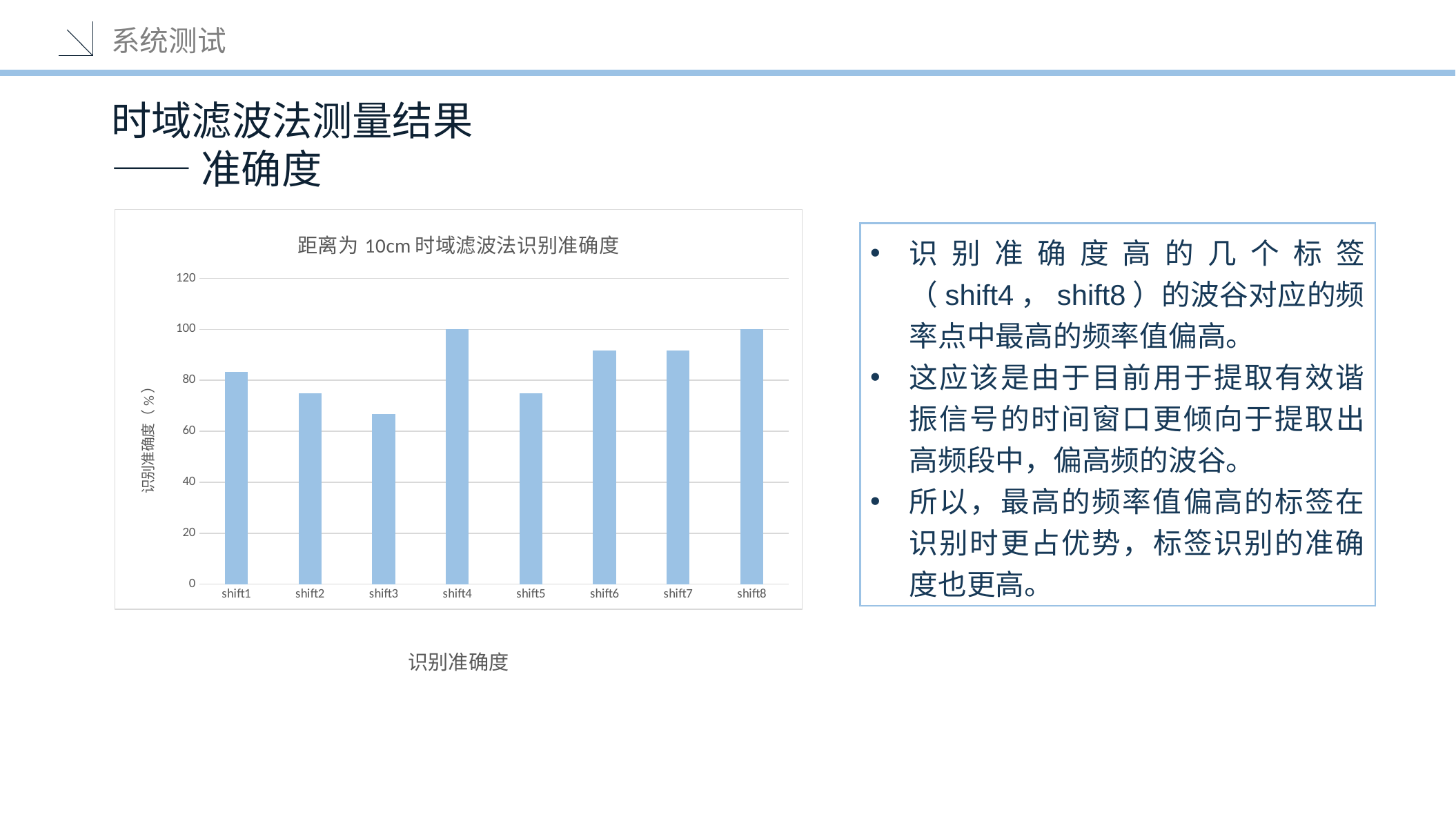
Which category has the lowest value in the chart? shift3 What is the title of the chart? 距离为 10cm 时域滤波法识别准确度 What is the label of the y axis of the chart? 识别准确度（%） What kind of chart is shown on the slide? bar chart Is the value for shift6 greater or less than 80? greater Is the value for shift2 greater or less than 80? less Is the value for shift1 greater or less than 80? greater How many categories (shift labels) are shown on the x axis of the chart? 8 Which is larger, the value for shift1 or the value for shift3? shift1 What is the value for shift4 in the chart? 100 What is the value for shift8 in the chart? 100